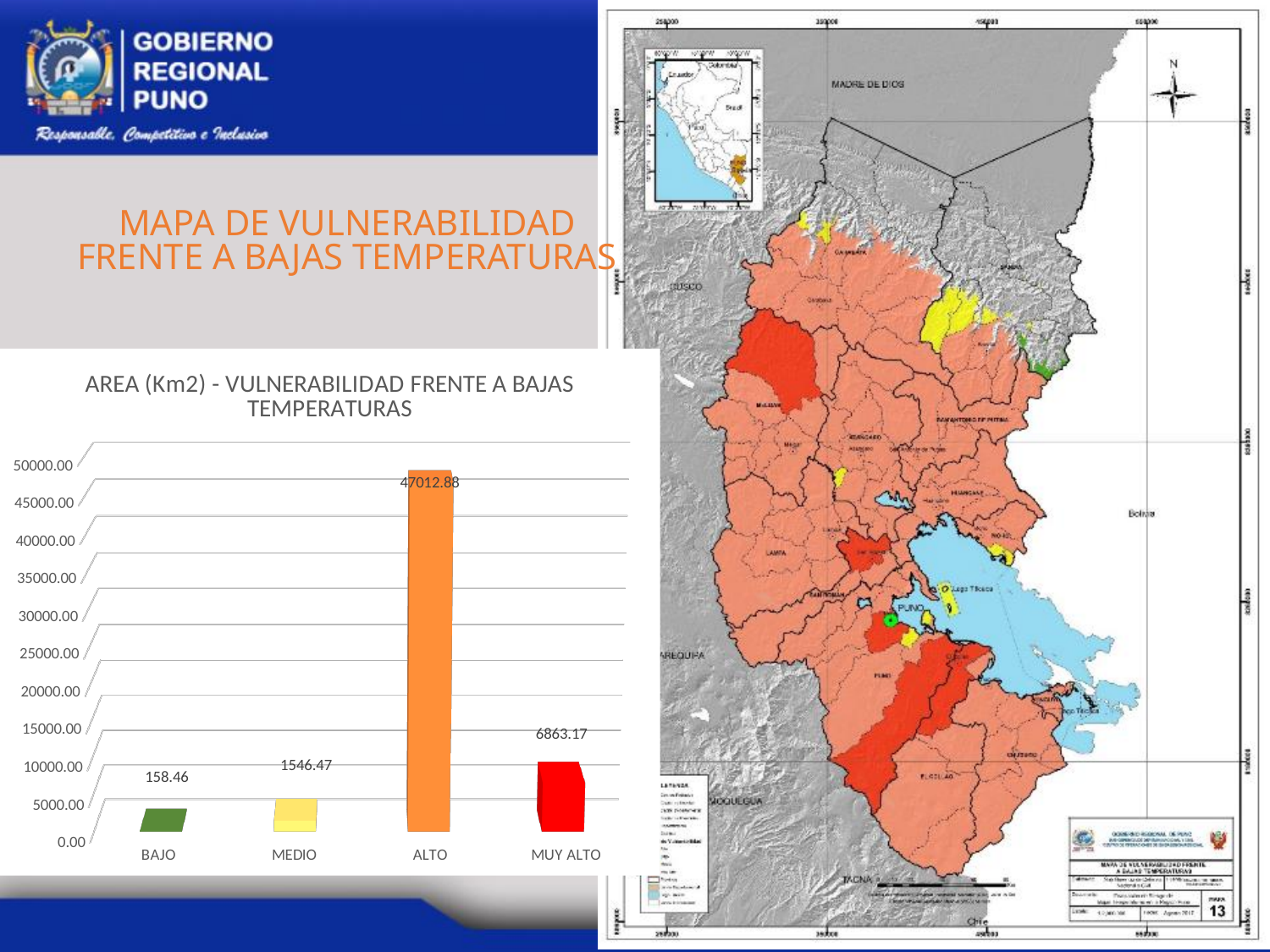
What is the value for MEDIO in the chart? 1546.47 Is the value for ALTO greater or less than 45000.00? greater What is the title of the chart? AREA (Km2) - VULNERABILIDAD FRENTE A BAJAS TEMPERATURAS What is the value for BAJO in the chart? 158.46 What is the difference between the values for ALTO and MUY ALTO? 40149.71 What is the value for MUY ALTO in the chart? 6863.17 Which is larger, the value for MUY ALTO or the value for MEDIO? MUY ALTO What is the value for ALTO in the chart? 47012.88 How many categories are shown in the chart? 4 What is the difference between the values for MEDIO and BAJO? 1388.01 Which category has the highest value in the chart? ALTO Which category has the lowest value in the chart? BAJO